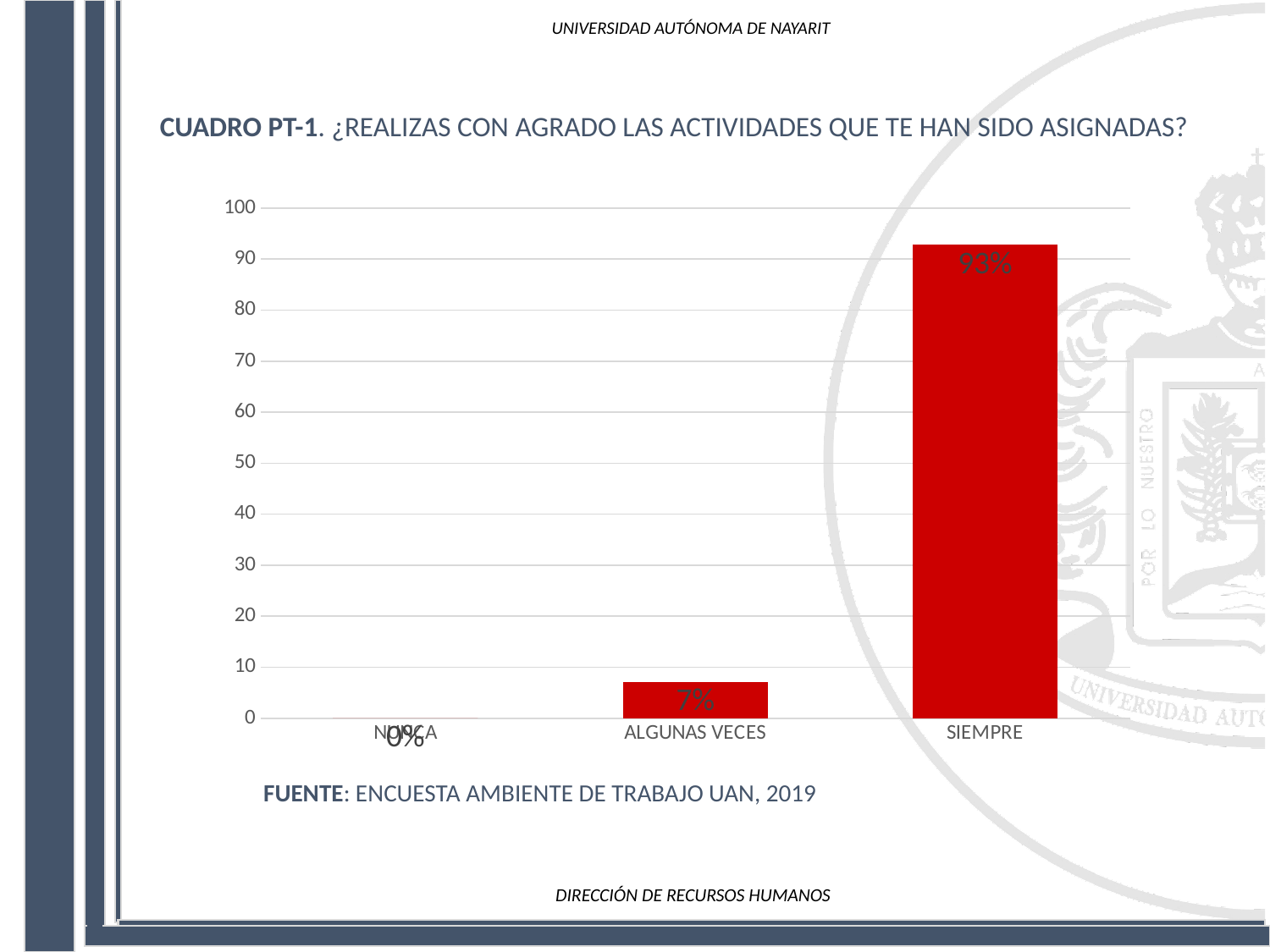
What kind of chart is shown on the slide? bar chart Is the value for ALGUNAS VECES greater or less than 10? less What is the value for SIEMPRE? 93% Which category has the highest value? SIEMPRE Which category has the lowest value? NUNCA What is the value for ALGUNAS VECES? 7% What source is cited below the chart? ENCUESTA AMBIENTE DE TRABAJO UAN, 2019 What is the difference between the values for SIEMPRE and ALGUNAS VECES? 86% Which is larger, the value for ALGUNAS VECES or the value for SIEMPRE? SIEMPRE How many categories are shown on the x axis? 3 Is the value for SIEMPRE greater or less than 90? greater What is the value for NUNCA? 0%